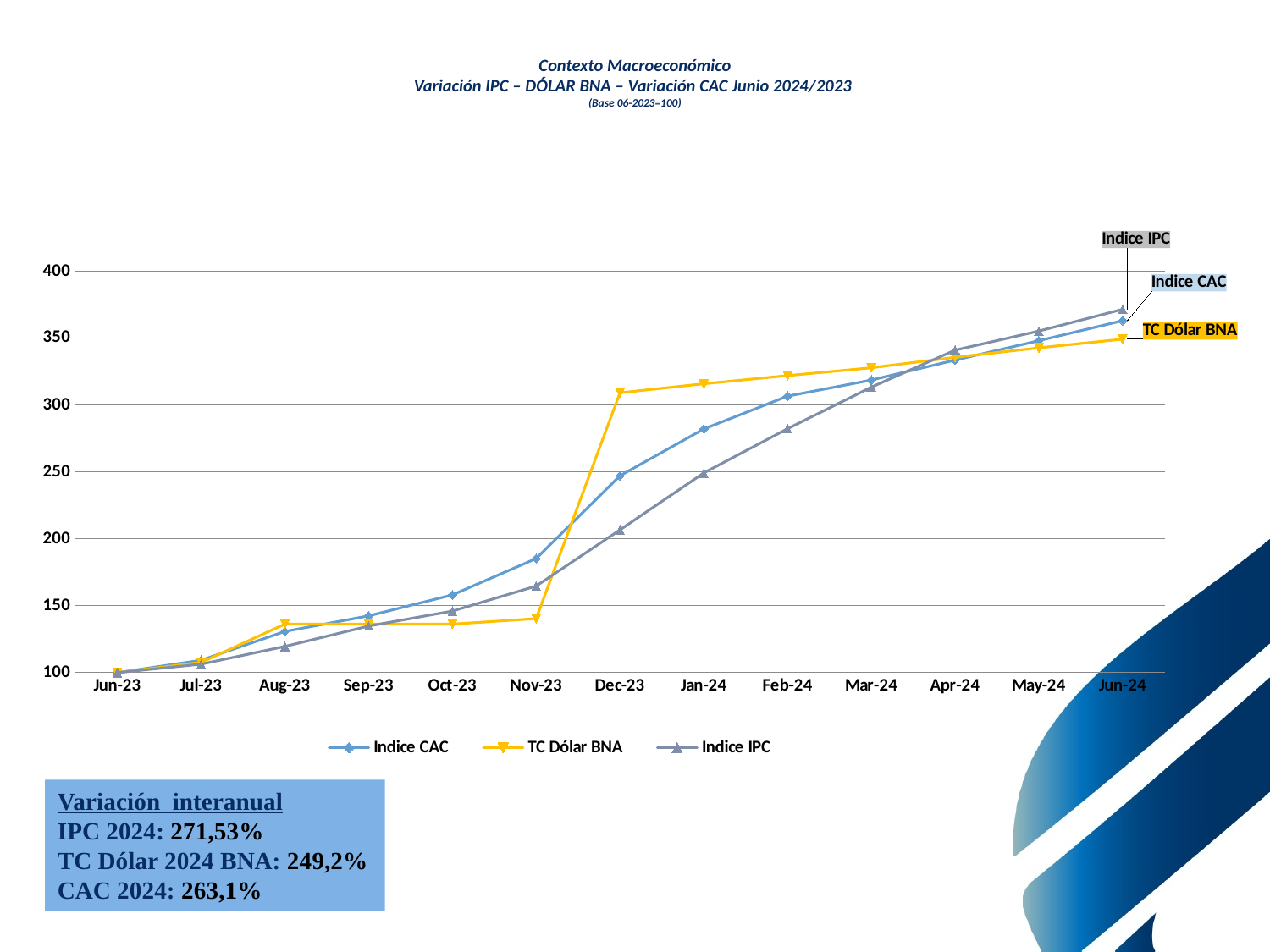
How many months are plotted along the x axis? 13 Is the value of TC Dólar BNA at Dec-23 greater or less than 300? greater Is the value of TC Dólar BNA at Nov-23 greater or less than 150? less What kind of chart is shown on the slide? line chart At Dec-23, which is higher: TC Dólar BNA or Indice IPC? TC Dólar BNA Is the value of Indice IPC at Jun-24 greater or less than 350? greater How many series does the legend list? 3 What base period is stated in the chart title? 06-2023=100 What is the value of Indice CAC at Jun-23? 100 Do the values of Indice IPC rise or fall from Jun-23 to Jun-24? rise Which series has the highest value at Jun-24? Indice IPC